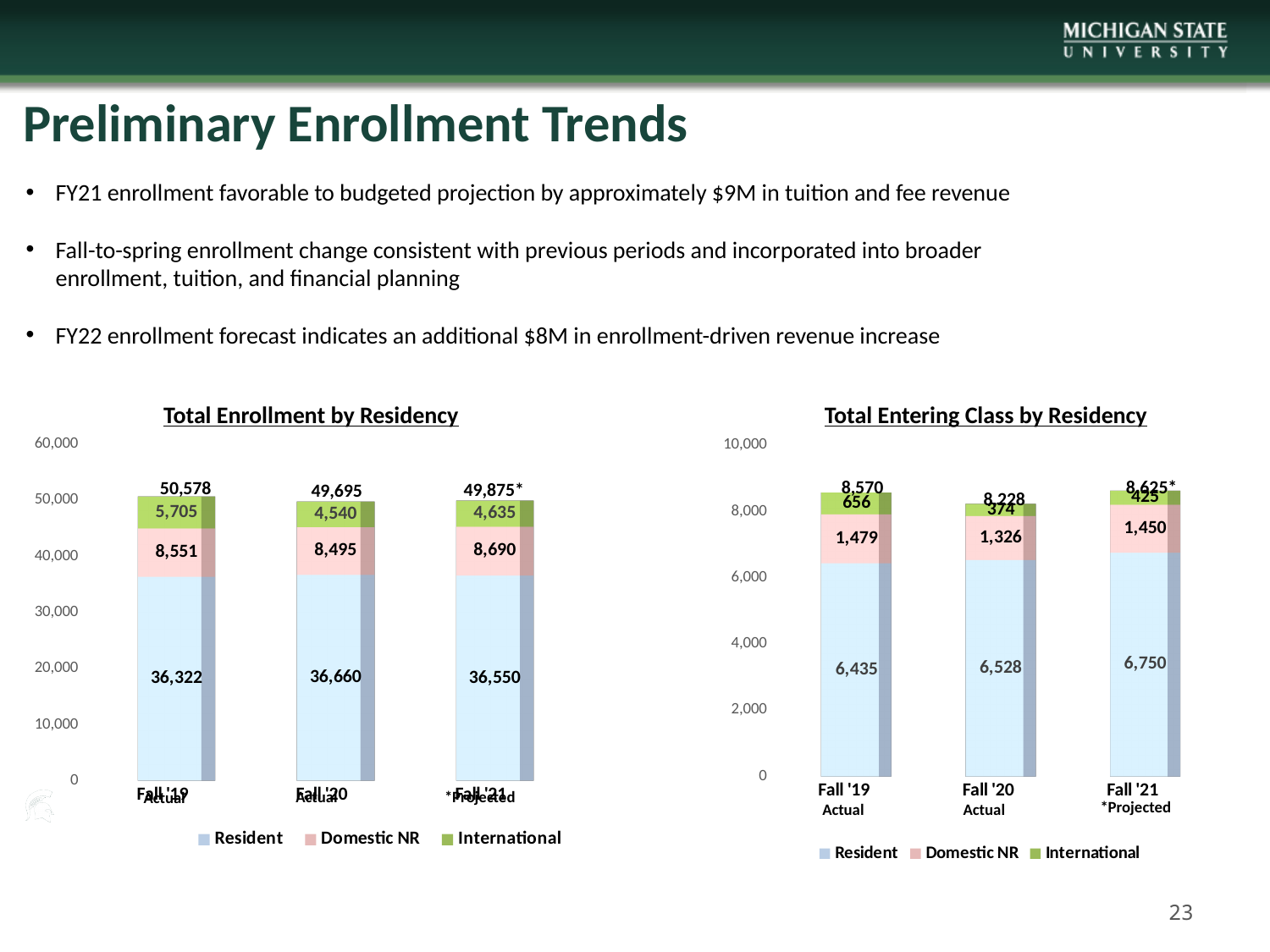
In the Total Enrollment by Residency chart, what is the International value for Fall '20? 4,540 In the Total Entering Class by Residency chart, which period has the lowest total entering class? Fall '20 In the Total Enrollment by Residency chart, what is the total shown above the Fall '21 bar? 49,875* How many series does the legend of the Total Enrollment by Residency chart list? 3 In the Total Entering Class by Residency chart, is the Domestic NR value larger for Fall '19 or Fall '21? Fall '19 In the Total Enrollment by Residency chart, which period has the highest total enrollment? Fall '19 In the Total Enrollment by Residency chart, what is the Resident value for Fall '19? 36,322 In the Total Enrollment by Residency chart, what is the difference between the Domestic NR values for Fall '21 and Fall '20? 195 In the Total Entering Class by Residency chart, what is the International value for Fall '20? 374 In the Total Entering Class by Residency chart, what is the Resident value for Fall '21? 6,750 In the Total Entering Class by Residency chart, what is the difference between the International values for Fall '19 and Fall '20? 282 What type of chart is the Total Entering Class by Residency chart? Stacked bar chart